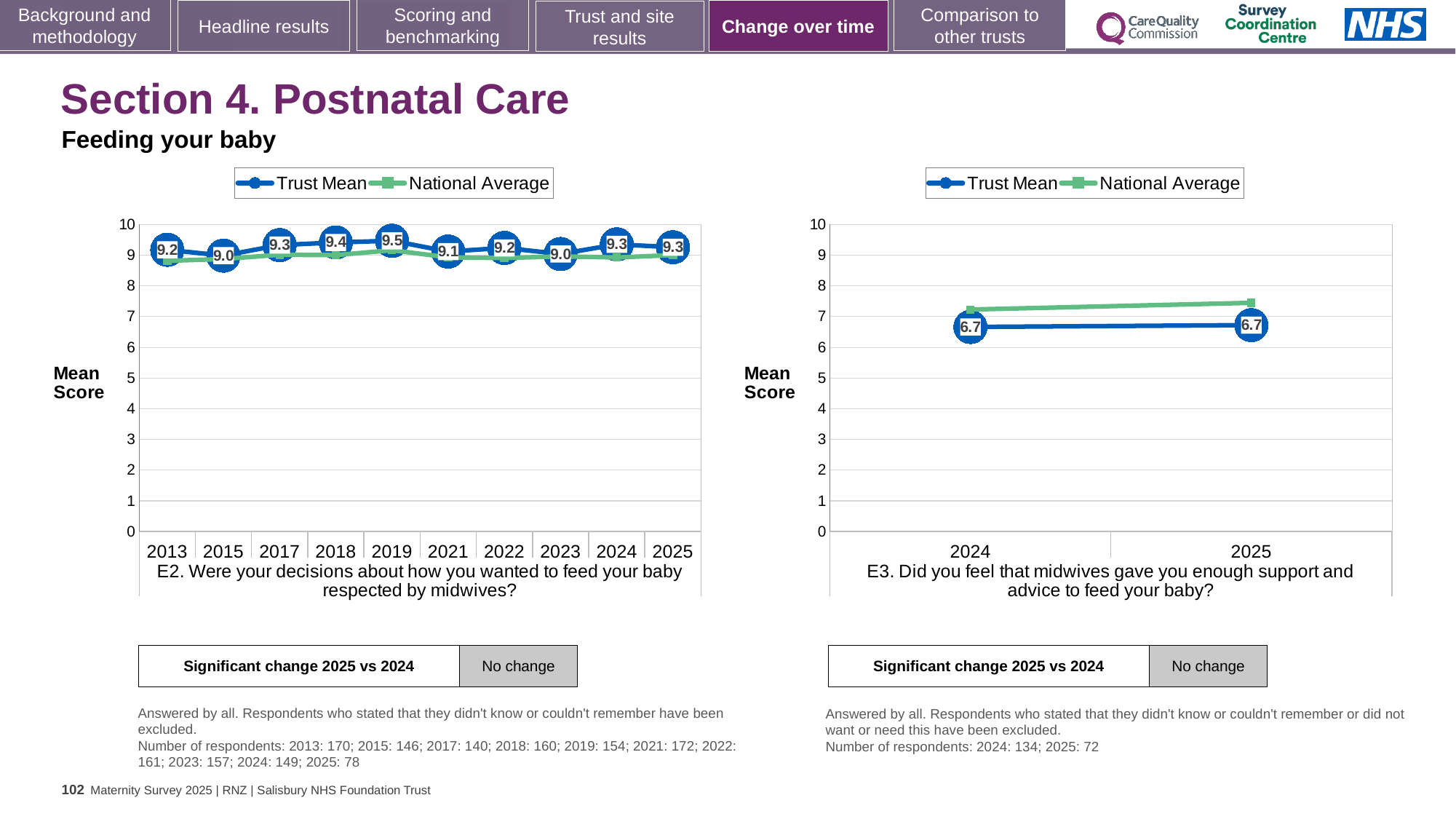
In the right chart (E3), does the National Average rise or fall from 2024 to 2025? Rise In the left chart (E2), what is the Trust Mean score for 2019? 9.5 What is the question text shown beneath the left chart? E2. Were your decisions about how you wanted to feed your baby respected by midwives? In the left chart (E2), what is the Trust Mean score for 2015? 9.0 In the right chart (E3), is the National Average value for 2025 greater or less than 7? greater In the left chart (E2), which year has the highest Trust Mean score? 2019 In the left chart (E2), is the Trust Mean score higher in 2018 or in 2023? 2018 In the left chart (E2), what is the difference between the Trust Mean scores for 2019 and 2021? 0.4 In the right chart (E3), what is the Trust Mean score for 2025? 6.7 What kind of chart is the right chart (E3)? Line chart In the right chart (E3), how many series does the legend list? 2 In the left chart (E2), how many years are shown on the x axis? 10